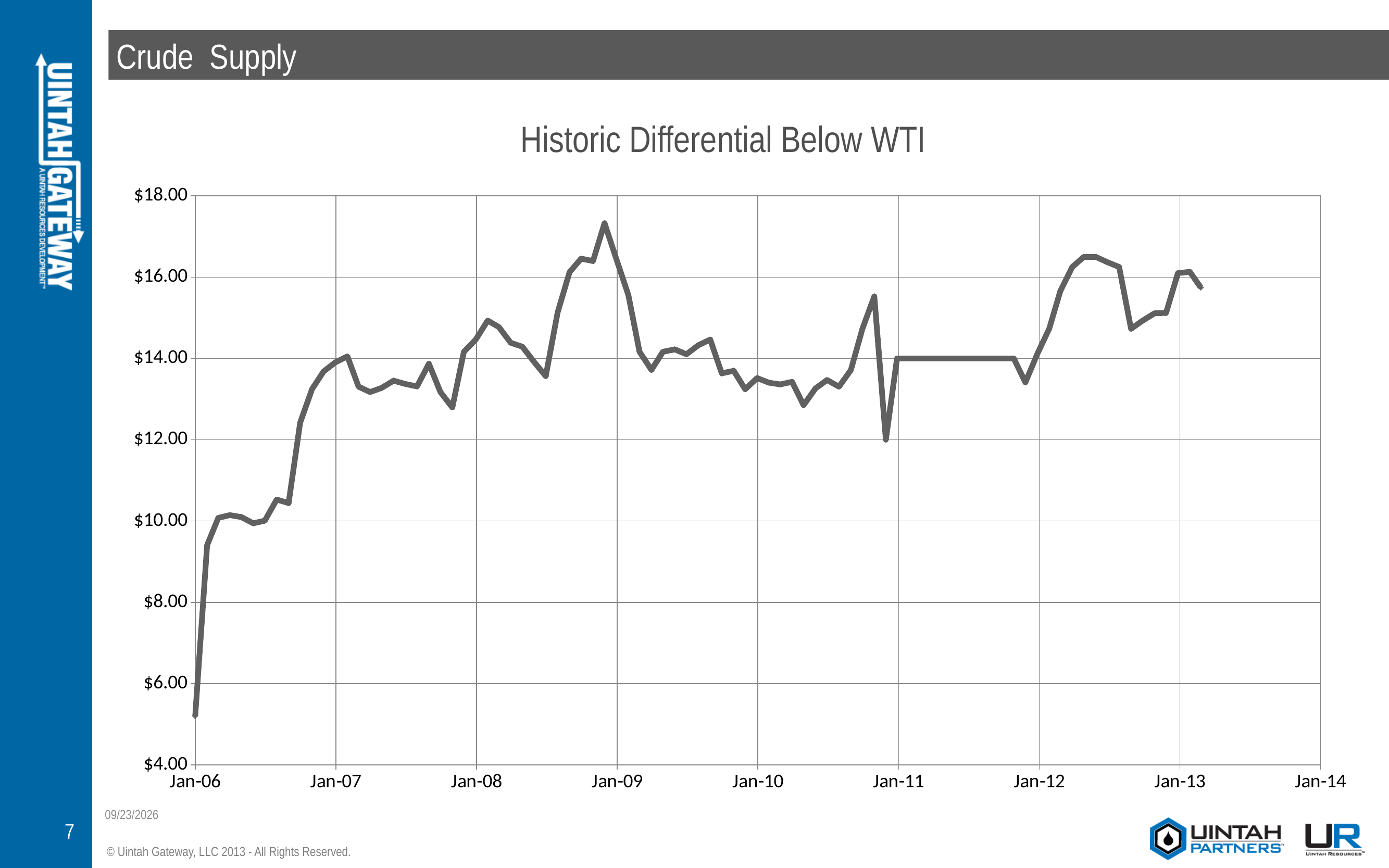
Around which x-axis label does the line reach its highest point? Jan-09 Is the value at Jan-06 greater or less than $6.00? less Is the peak value reached just before Jan-09 greater or less than $16.00? greater Which is larger, the value at Jan-06 or the value at Jan-07? Jan-07 What is the title of the chart? Historic Differential Below WTI Does the line generally rise or fall from Jan-06 to Jan-07? rise How many year labels are shown on the x axis? 9 What kind of chart is shown on the slide? line chart At which x-axis label is the line at its lowest point? Jan-06 Is the value at Jan-13 greater or less than $14.00? greater At what value does the line hold flat between Jan-11 and Jan-12? $14.00